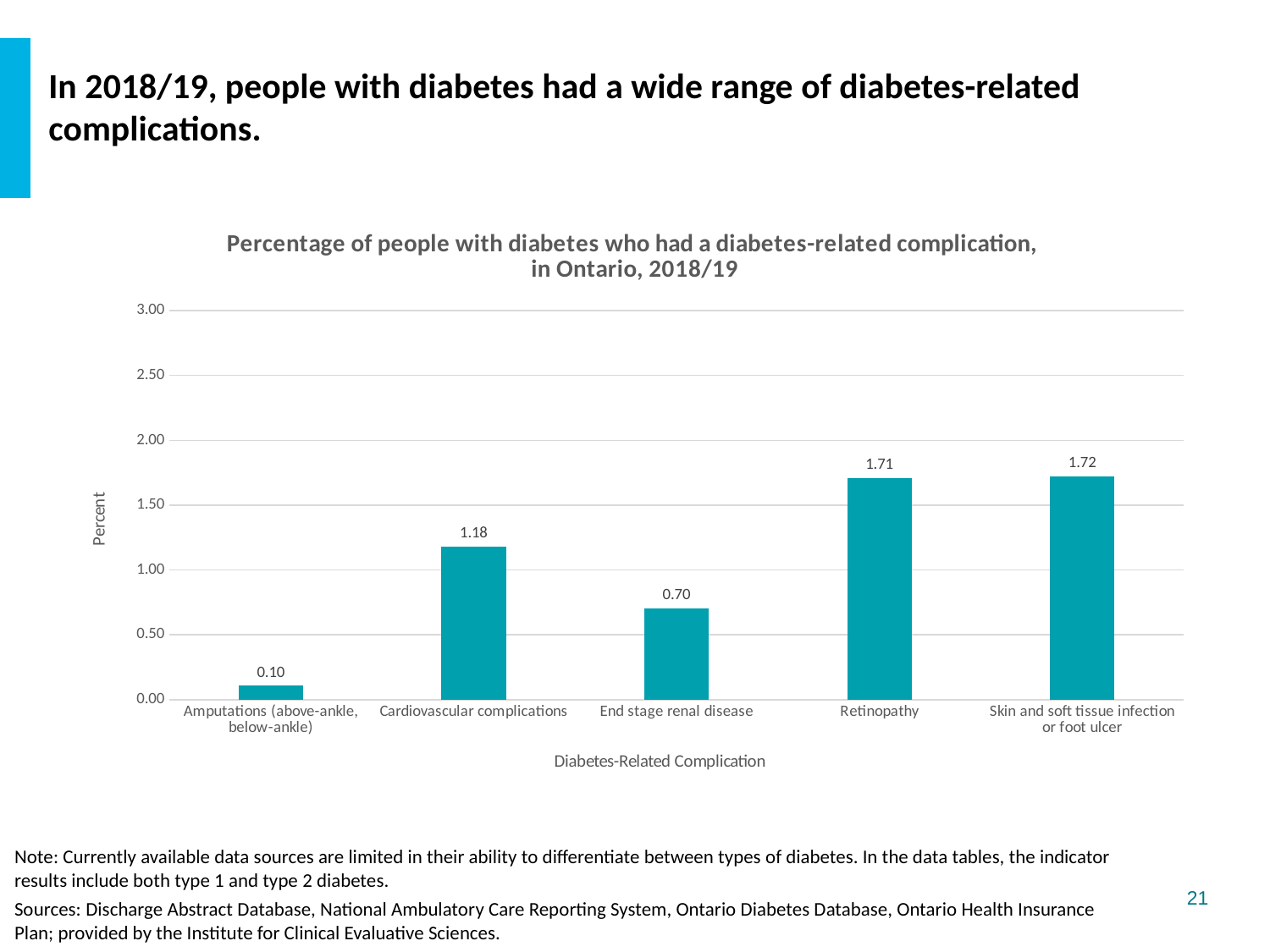
How many diabetes-related complication categories are shown in the chart? 5 What is the value for Amputations (above-ankle, below-ankle)? 0.10 Which diabetes-related complication has the lowest percentage? Amputations (above-ankle, below-ankle) What is the difference between the values for Cardiovascular complications and End stage renal disease? 0.48 Is the value for Cardiovascular complications greater or less than 1.00? greater What is the label of the y axis of the chart? Percent What kind of chart is shown on the slide? Bar chart What is the value for End stage renal disease? 0.70 What is the value for Retinopathy? 1.71 What is the difference between the values for Skin and soft tissue infection or foot ulcer and Amputations (above-ankle, below-ankle)? 1.62 Which is larger, the value for Retinopathy or the value for End stage renal disease? Retinopathy What is the value for Cardiovascular complications? 1.18